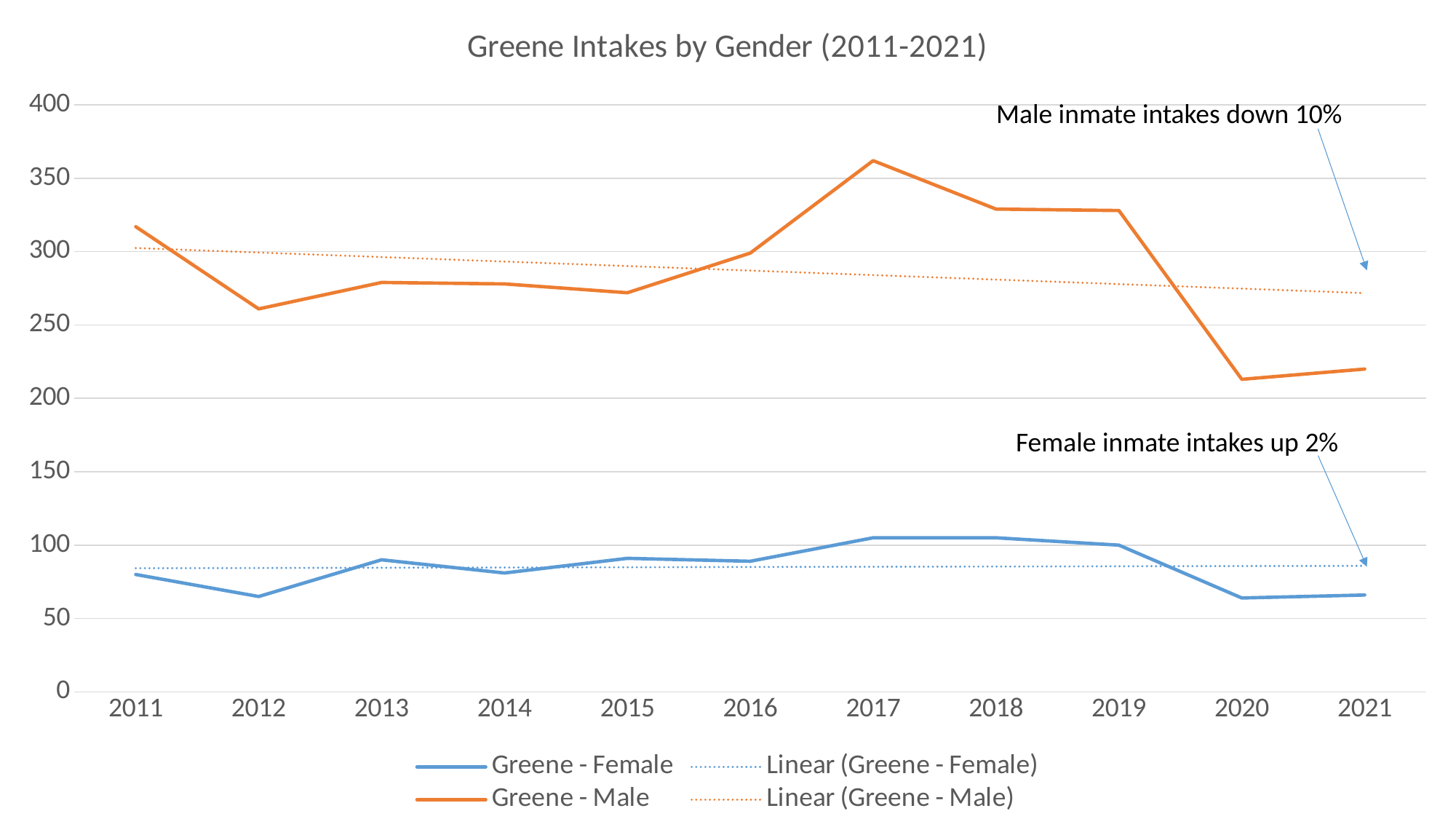
Is the Greene - Female value for 2012 greater or less than 100? less In which year is the Greene - Male series at its highest? 2017 Does the Greene - Male series rise or fall from 2019 to 2020? fall Is the Greene - Male value for 2017 greater or less than 350? greater According to the annotation on the chart, by what percentage are male inmate intakes down? 10% What kind of chart is shown on the slide? line chart What is the title of the chart? Greene Intakes by Gender (2011-2021) How many entries does the legend list? 4 Is the Greene - Male value for 2011 greater or less than 300? greater How many years are shown along the x axis? 11 Which is larger for Greene - Male: the value in 2017 or the value in 2012? 2017